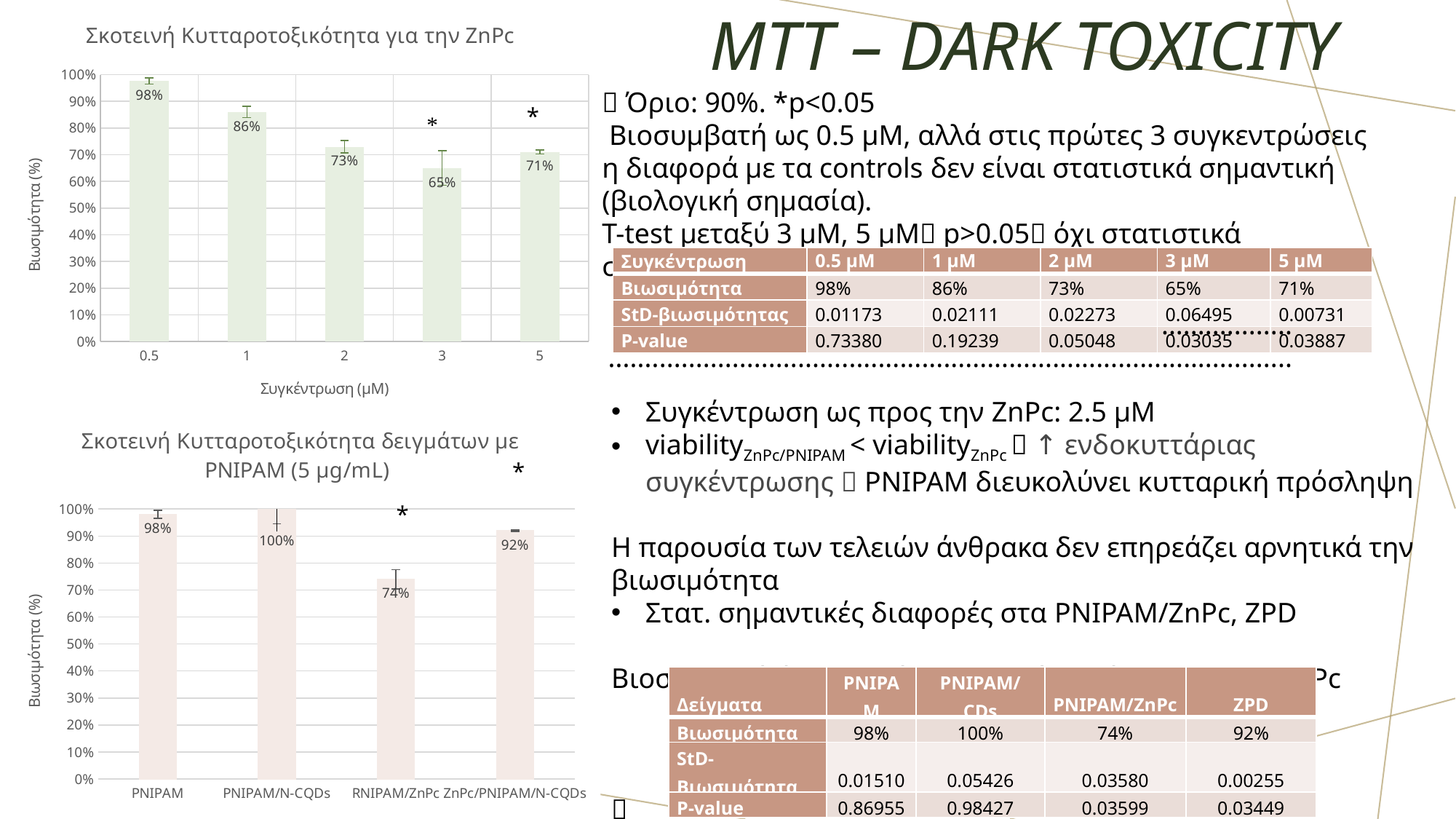
What is the x-axis title of the top chart (Σκοτεινή Κυτταροτοξικότητα για την ZnPc)? Συγκέντρωση (μΜ) In the bottom chart (Σκοτεινή Κυτταροτοξικότητα δειγμάτων με PNIPAM), what is the viability for PNIPAM/N-CQDs? 100% In the bottom chart (Σκοτεινή Κυτταροτοξικότητα δειγμάτων με PNIPAM), what is the difference in viability between PNIPAM and RNIPAM/ZnPc? 24% In the top chart (Σκοτεινή Κυτταροτοξικότητα για την ZnPc), what is the viability at a concentration of 0.5 μM? 98% How many concentration categories are plotted in the top chart (Σκοτεινή Κυτταροτοξικότητα για την ZnPc)? 5 In the bottom chart (Σκοτεινή Κυτταροτοξικότητα δειγμάτων με PNIPAM), which sample has the lowest viability? RNIPAM/ZnPc In the top chart (Σκοτεινή Κυτταροτοξικότητα για την ZnPc), what is the difference in viability between 0.5 μM and 1 μM? 12% What type of chart is the top chart (Σκοτεινή Κυτταροτοξικότητα για την ZnPc)? Bar chart In the top chart (Σκοτεινή Κυτταροτοξικότητα για την ZnPc), which concentration has the lowest viability? 3 In the bottom chart (Σκοτεινή Κυτταροτοξικότητα δειγμάτων με PNIPAM), is the value for ZnPc/PNIPAM/N-CQDs greater or less than 90%? greater In the top chart (Σκοτεινή Κυτταροτοξικότητα για την ZnPc), which has higher viability: 2 μM or 5 μM? 2 μM In the top chart (Σκοτεινή Κυτταροτοξικότητα για την ZnPc), what is the viability at 3 μM? 65%